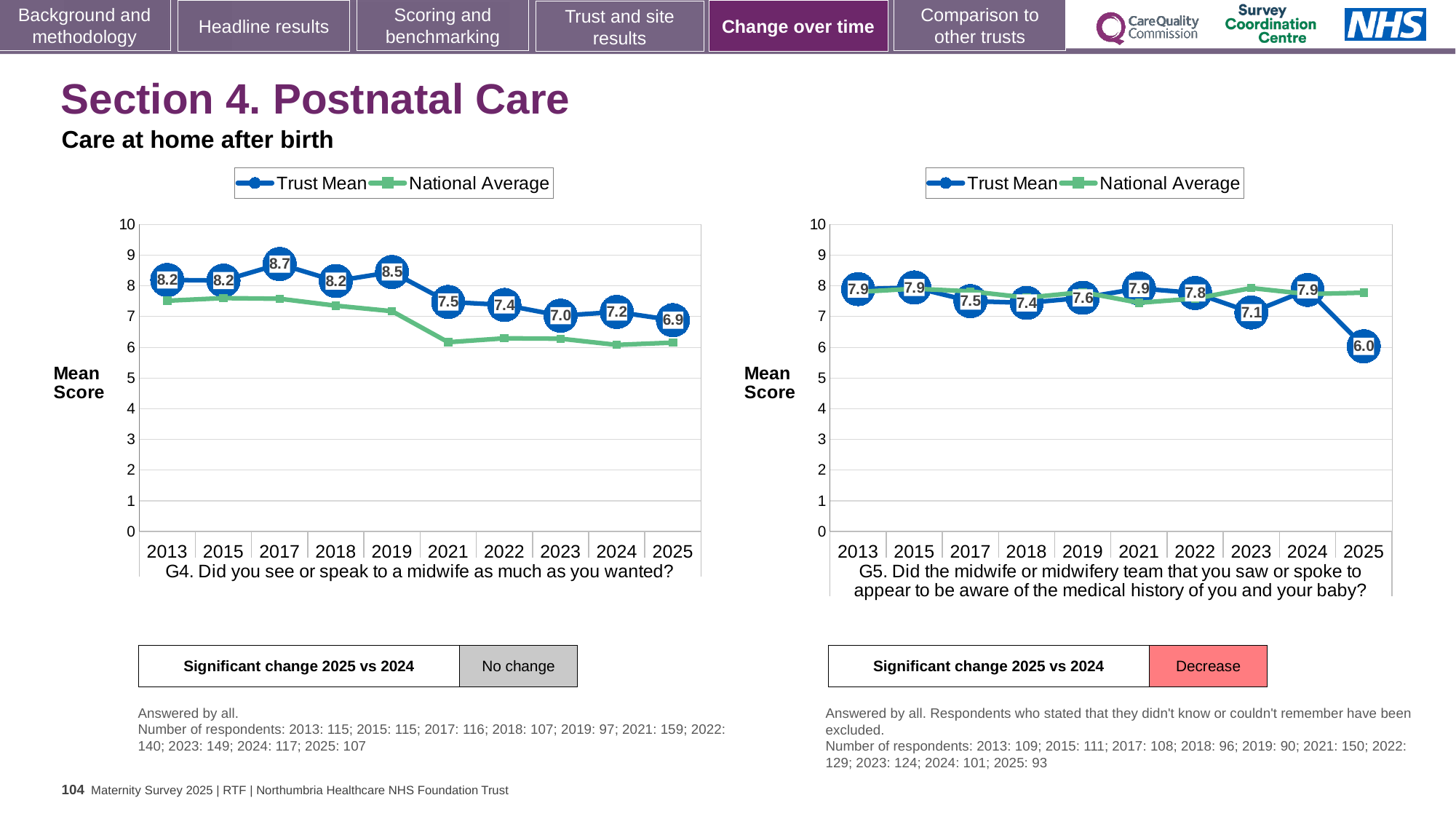
In the G4 chart (left), does the Trust Mean rise or fall from 2019 to 2025? Fall How many years are plotted on the x axis of the G5 chart (right)? 10 What kind of chart is the G4 chart (left)? Line chart In the G5 chart (right), what is the Trust Mean for 2025? 6.0 In the G4 chart (left), what is the difference between the Trust Mean in 2013 and in 2025? 1.3 In the G4 chart (left), is the National Average for 2025 greater or less than 7? less How many series does the legend of the G4 chart (left) list? 2 What significant change 2025 vs 2024 is shown below the G5 chart (right)? Decrease In the G4 chart (left), what is the Trust Mean for 2017? 8.7 In the G4 chart (left), which year has the highest Trust Mean? 2017 In the G5 chart (right), which year has the lowest Trust Mean? 2025 In the G5 chart (right), which is larger, the Trust Mean for 2019 or for 2023? 2019